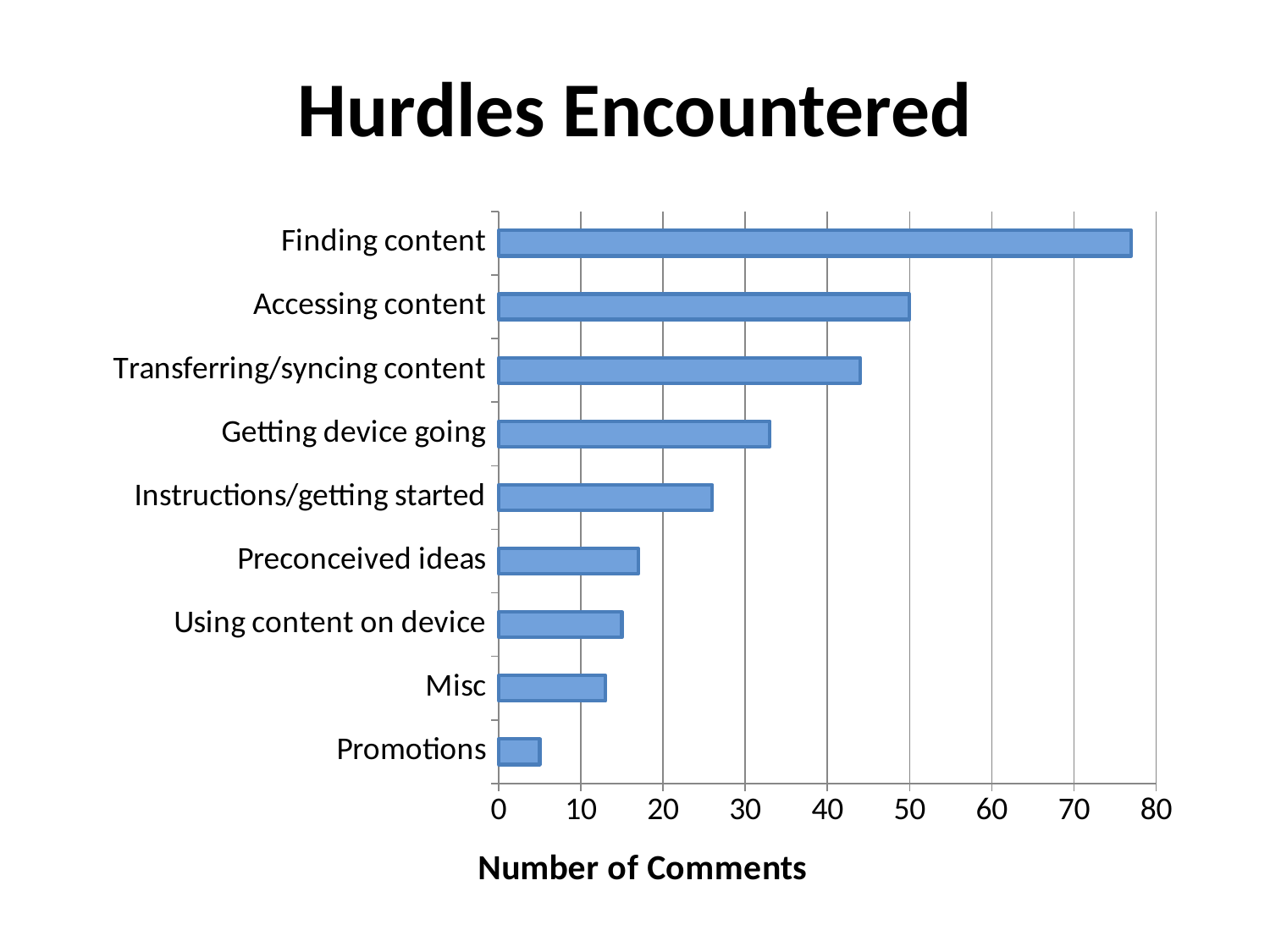
Is the value for Getting device going greater or less than 30? greater Is the value for Finding content greater or less than 70? greater How many categories are shown in the chart? 9 Is the value for Promotions greater or less than 10? less Which category has the highest number of comments? Finding content Which has more comments, Accessing content or Transferring/syncing content? Accessing content Which category has the lowest number of comments? Promotions What is the title of the chart? Hurdles Encountered What is the label on the horizontal axis? Number of Comments What kind of chart is shown on the slide? bar chart